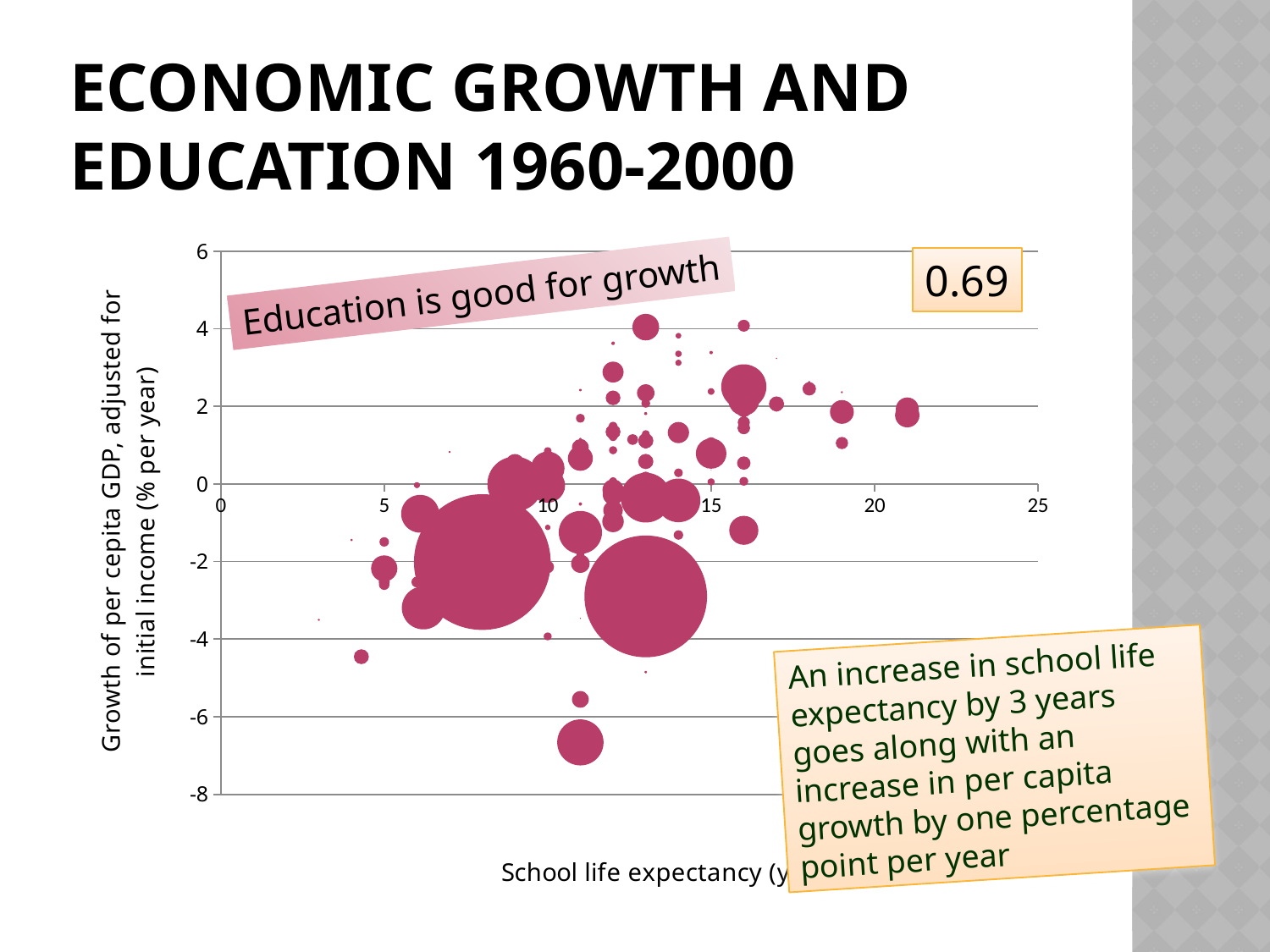
Do the plotted growth values generally rise or fall as school life expectancy increases along the x axis? rise What is the title of the vertical axis of the chart? Growth of per cepita GDP, adjusted for initial income (% per year) Is the growth value of the largest bubble on the chart greater or less than 0? less Is the growth value of the lowest bubble on the chart greater or less than -6? less What number is shown in the box in the top-right corner of the chart? 0.69 What kind of chart is shown on the slide? bubble chart